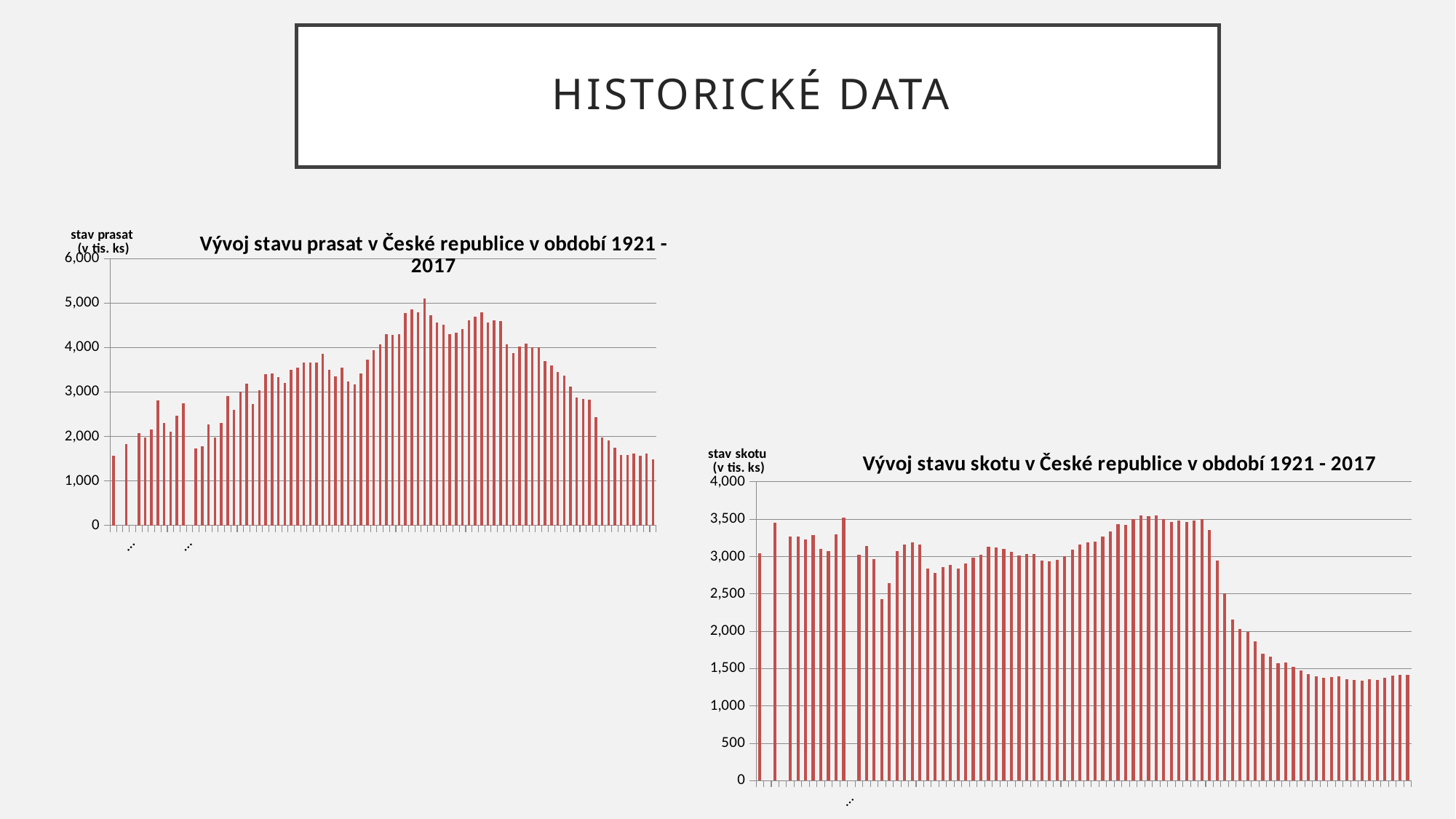
What kind of chart is the chart titled "Vývoj stavu skotu v České republice v období 1921 - 2017"? bar chart In the chart on the right (stav skotu), is the highest bar greater or less than 4,000? less In the chart on the right (stav skotu), do the values in the final part of the period rise or fall compared with the middle of the period? fall What is the highest tick value shown on the vertical axis of the chart on the right (stav skotu)? 4,000 In the chart on the left (stav prasat), is the highest bar greater or less than 4,000? greater What kind of chart is the chart titled "Vývoj stavu prasat v České republice v období 1921 - 2017"? bar chart In the chart on the left (stav prasat), is the value of the last bar greater or less than 2,000? less In the chart on the left (stav prasat), is the first bar or the highest bar larger? the highest bar What is the label of the vertical axis of the chart on the left? stav prasat (v tis. ks)